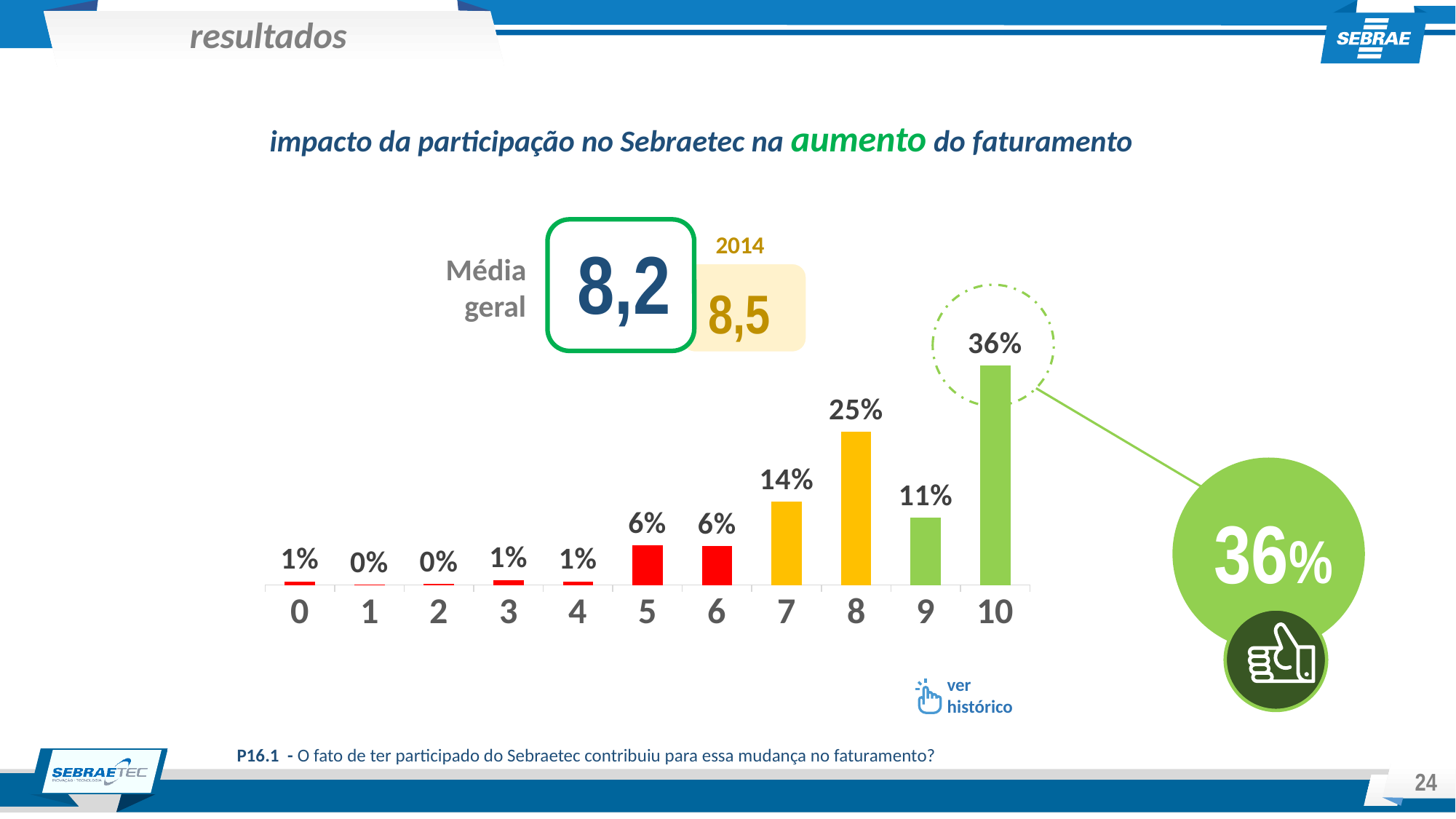
What is the value for category 10? 36% What is the 'Média geral' value shown in the green box? 8,2 What is the value for category 8? 25% Which category has the highest value? 10 Which is larger, the value for category 7 or the value for category 9? 7 What is the value for category 7? 14% What kind of chart is shown on the slide? bar chart How many categories are shown on the x axis? 11 What is the value for category 9? 11% What is the 2014 value shown next to the 'Média geral' box? 8,5 What is the difference between the values for categories 8 and 9? 14% What is the difference between the values for categories 10 and 8? 11%